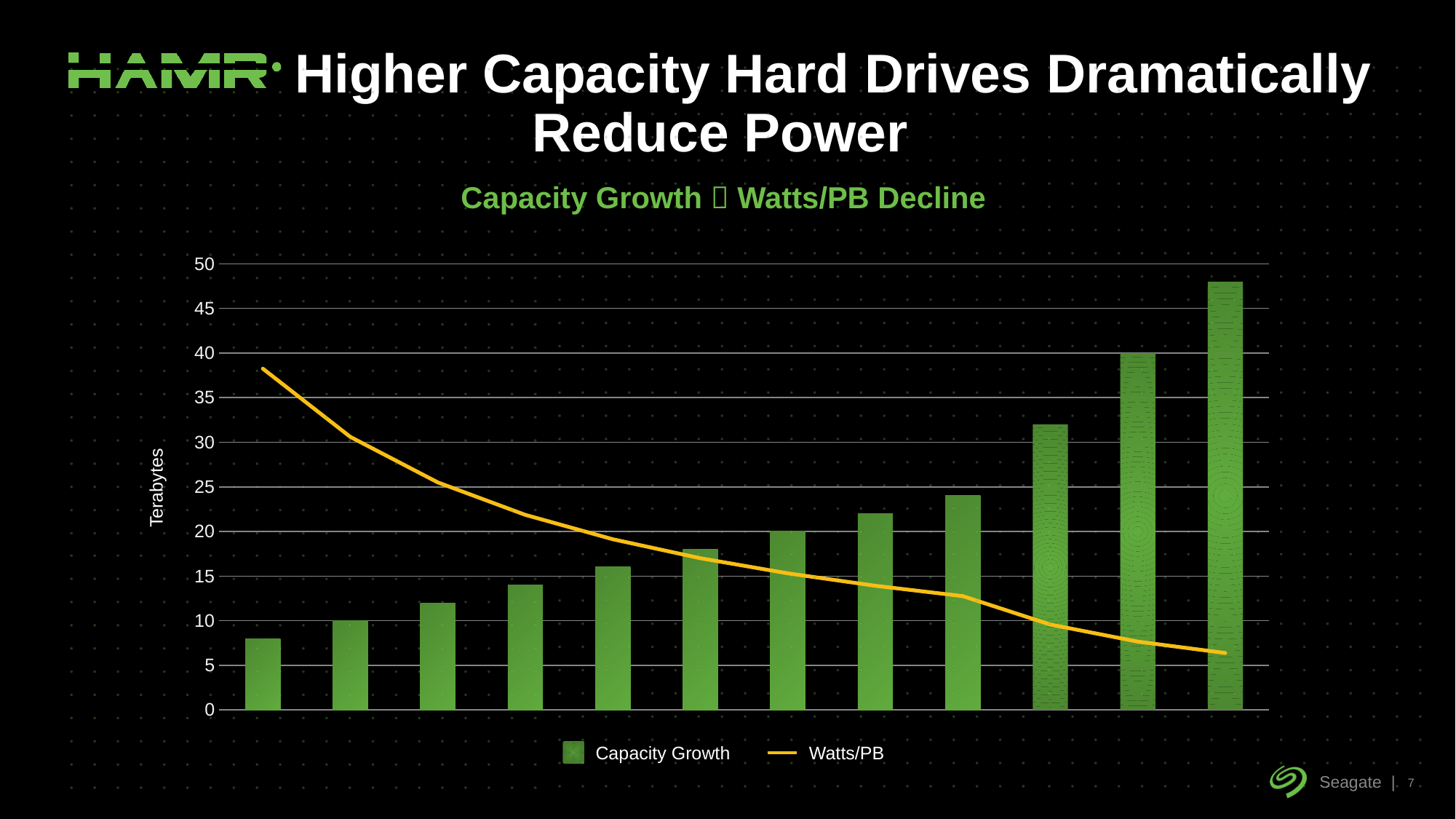
How many series does the legend list? 2 What is the value of the second bar from the left, in terabytes? 10 What is the label on the vertical axis? Terabytes Which bar is the tallest in the Capacity Growth series? The rightmost bar Is the value of the leftmost Capacity Growth bar greater or less than 10? less Do the Capacity Growth bars rise or fall from left to right? Rise How many bars does the chart contain? 12 Which bar is the shortest in the Capacity Growth series? The leftmost bar Does the Watts/PB line rise or fall from left to right? Fall Is the value of the rightmost Capacity Growth bar greater or less than 45? greater Which series is drawn as a line rather than bars? Watts/PB What kind of chart is shown on the slide? A bar chart combined with a line